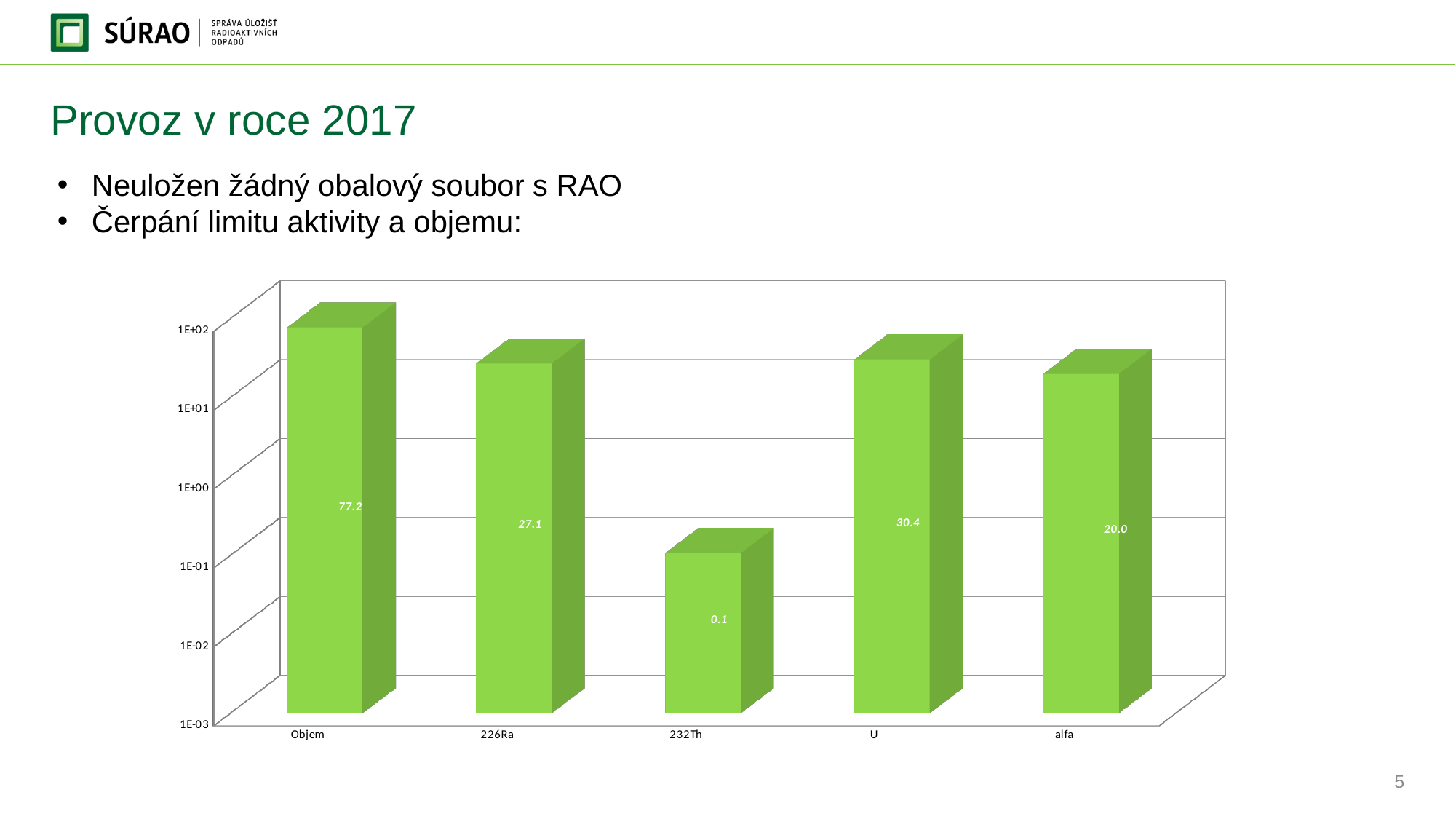
Which is larger, the value for U or the value for 226Ra? U What is the value shown for 226Ra? 27.1 Which category has the highest value? Objem What is the value shown for Objem? 77.2 What is the difference between the values for Objem and U? 46.8 Which category has the lowest value? 232Th What is the value shown for alfa? 20.0 What kind of chart is shown on the slide? Bar chart What is the value shown for U? 30.4 What is the value shown for 232Th? 0.1 What is the lowest tick label shown on the vertical axis? 1E-03 How many categories are shown on the x axis? 5